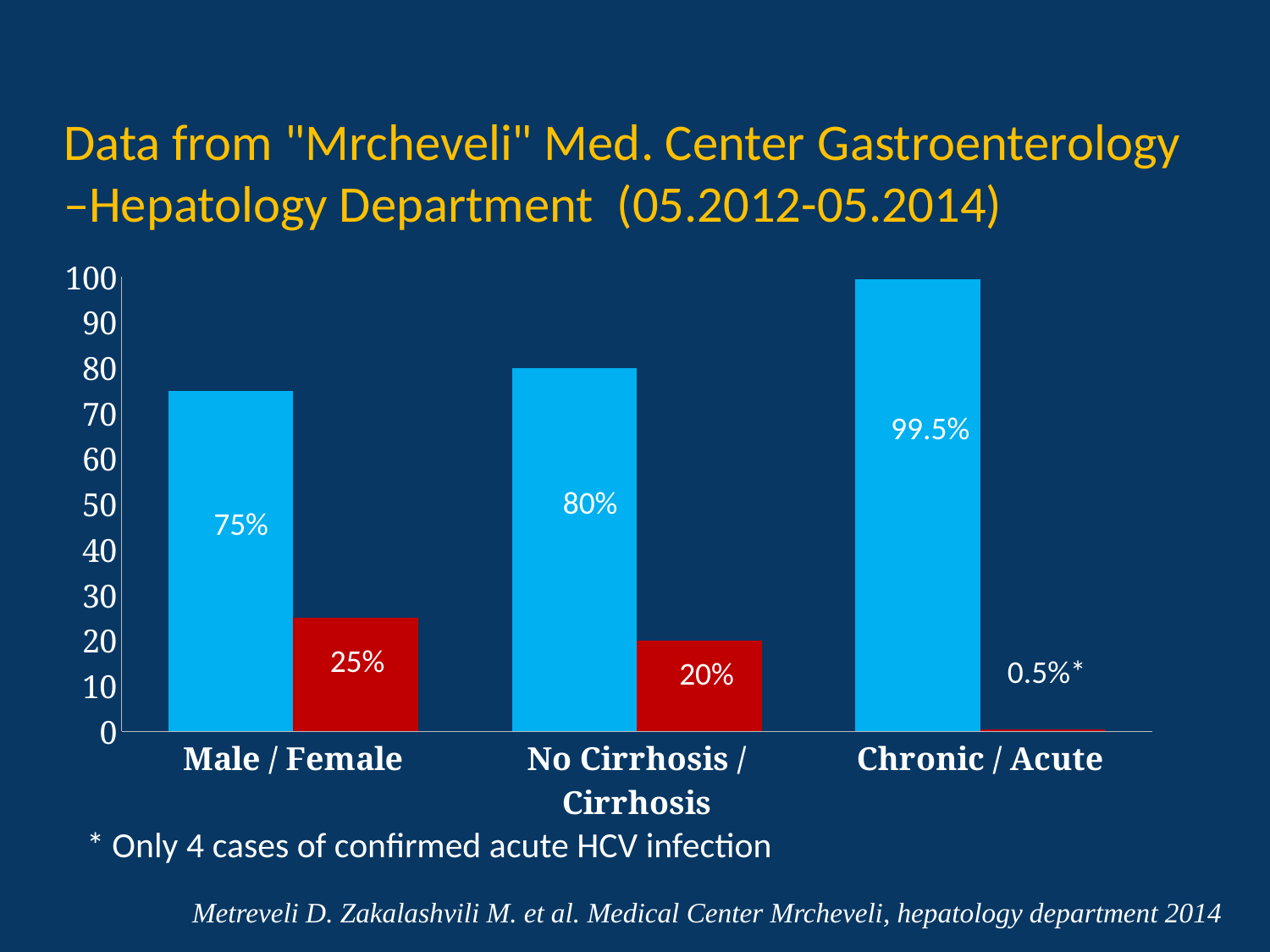
What percentage is shown for the blue bar in the "Male / Female" group? 75% What value is labelled on the red bar in the "No Cirrhosis / Cirrhosis" group? 20% What value is labelled on the blue bar in the "No Cirrhosis / Cirrhosis" group? 80% What is the difference between the blue bar values of the "No Cirrhosis / Cirrhosis" group and the "Male / Female" group? 5% What kind of chart is shown on the slide? Bar chart What value is labelled for the red (Acute) bar in the "Chronic / Acute" group? 0.5% How many category groups are shown on the x axis of the chart? 3 Which category group has the shortest red bar? Chronic / Acute What percentage is shown for the red bar in the "Male / Female" group? 25% What value is labelled on the blue bar in the "Chronic / Acute" group? 99.5% Which category group has the tallest blue bar? Chronic / Acute Which is larger: the red bar in the "Male / Female" group or the red bar in the "No Cirrhosis / Cirrhosis" group? Male / Female